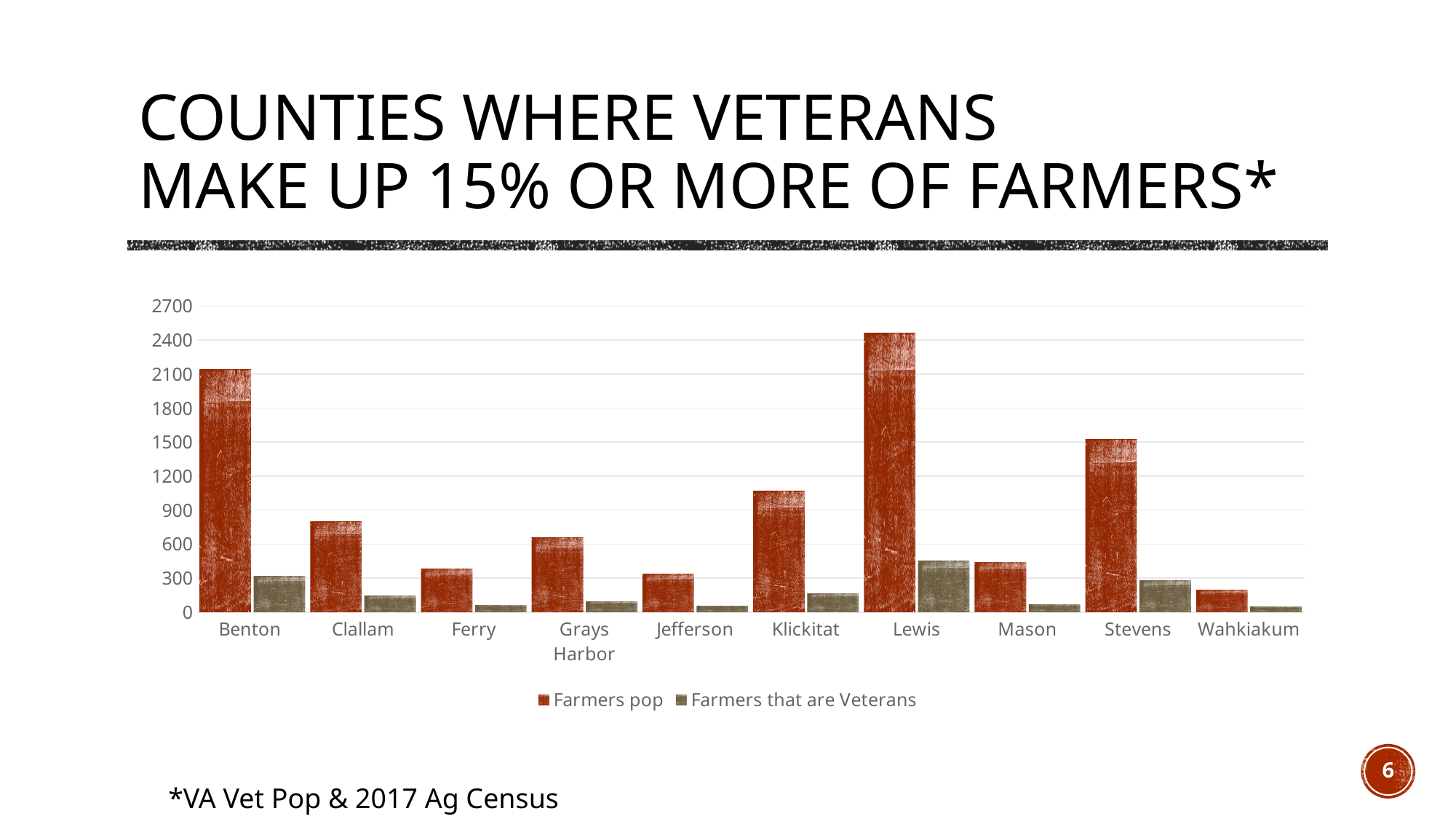
What kind of chart is shown on the slide? bar chart Is the Farmers pop value for Lewis greater or less than 2100? greater Is the Farmers pop value for Klickitat greater or less than 900? greater Which county has the highest value for Farmers that are Veterans? Lewis Which county has the highest Farmers pop value? Lewis What are the two series named in the chart's legend? Farmers pop and Farmers that are Veterans How many series does the chart's legend list? 2 Is the Farmers pop value for Clallam greater or less than 900? less Which county has the larger Farmers pop value, Benton or Stevens? Benton Which county has the lowest Farmers pop value? Wahkiakum How many counties are shown on the x axis of the chart? 10